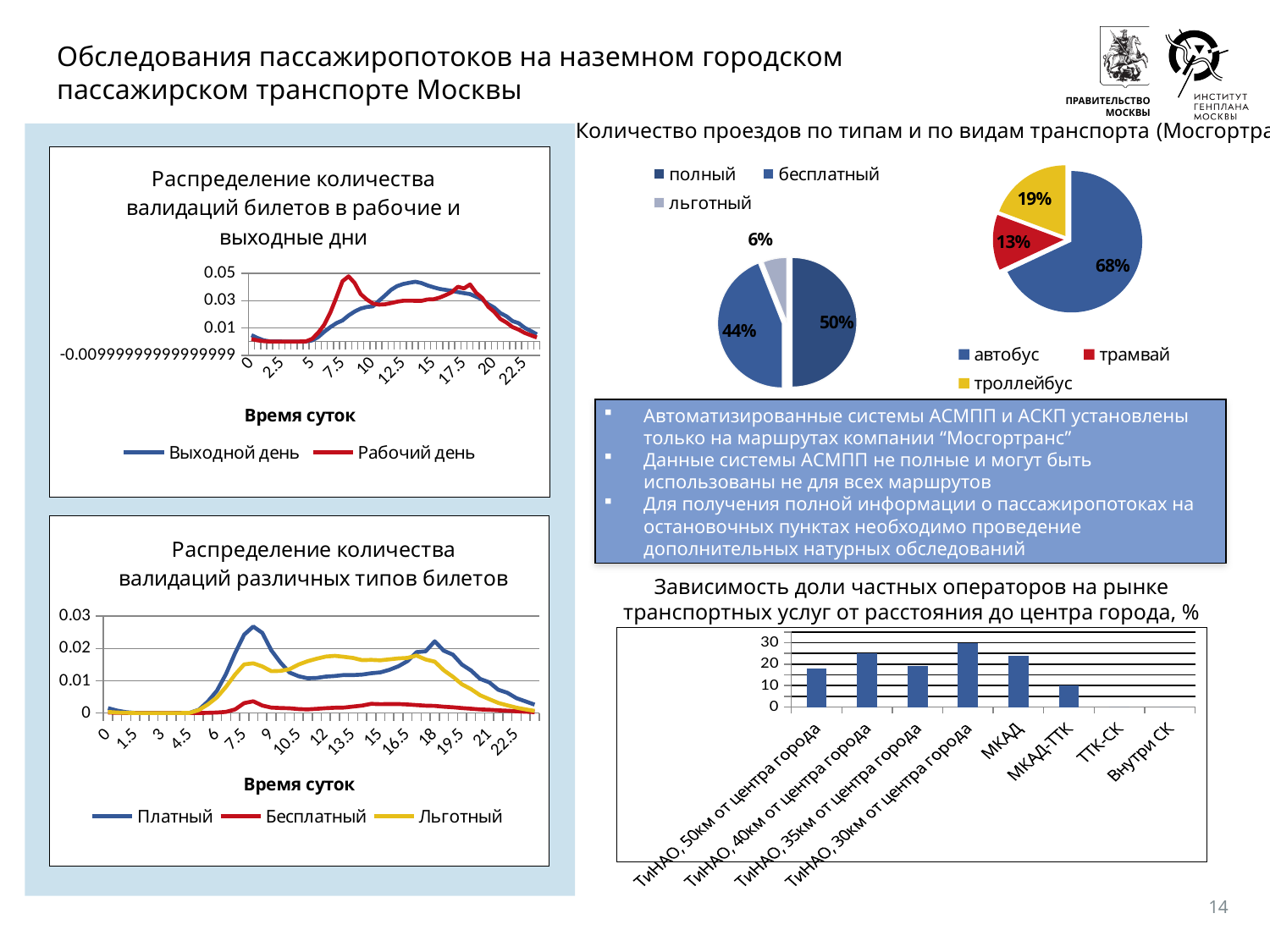
In the pie chart with the legend автобус, трамвай, троллейбус, what share is автобус? 68% In the pie chart with the legend полный, бесплатный, льготный, what share is льготный? 6% In the chart 'Зависимость доли частных операторов на рынке транспортных услуг от расстояния до центра города, %', is the value for 'ТиНАО, 40км от центра города' greater or less than 20? greater How many series does the legend of the chart 'Распределение количества валидаций различных типов билетов' list? 3 In the pie chart with the legend автобус, трамвай, троллейбус, what is the difference in percentage points between троллейбус and трамвай? 6 In the pie chart with the legend полный, бесплатный, льготный, what share is полный? 50% What kind of chart is 'Распределение количества валидаций билетов в рабочие и выходные дни'? line chart How many categories are shown on the x axis of the chart 'Зависимость доли частных операторов на рынке транспортных услуг от расстояния до центра города, %'? 8 In the pie chart with the legend автобус, трамвай, троллейбус, which category has the smallest share? трамвай In the chart 'Зависимость доли частных операторов на рынке транспортных услуг от расстояния до центра города, %', is the value for 'ТиНАО, 50км от центра города' greater or less than 20? less In the pie chart with the legend полный, бесплатный, льготный, which is larger, полный or бесплатный? полный What kind of chart is 'Зависимость доли частных операторов на рынке транспортных услуг от расстояния до центра города, %'? bar chart